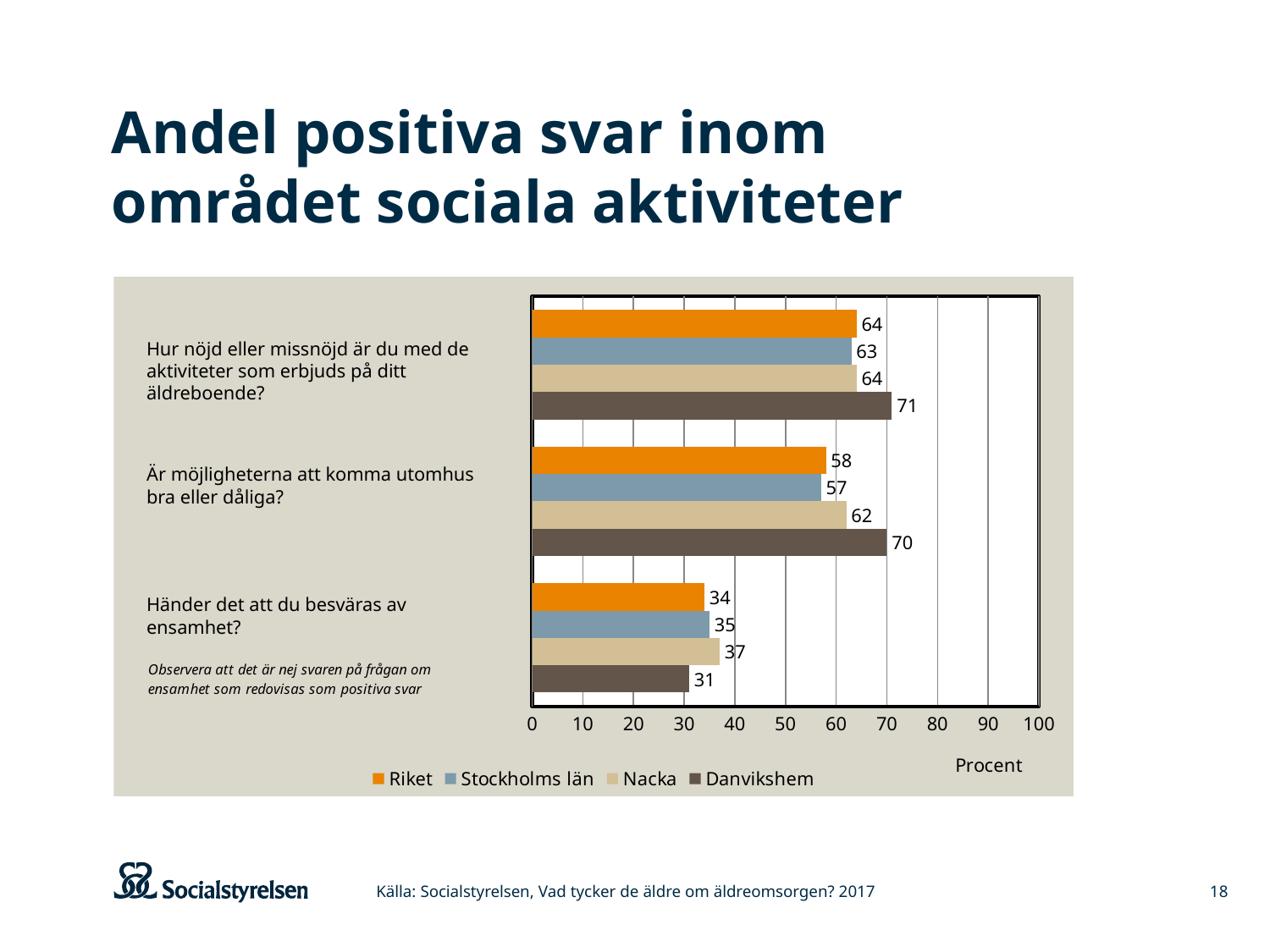
What is the value for Nacka on the question "Händer det att du besväras av ensamhet?"? 37 What kind of chart is shown on the slide? Bar chart Which colour represents Riket in the legend? Orange How many question categories are shown on the chart? 3 What is the value for Stockholms län on the question "Är möjligheterna att komma utomhus bra eller dåliga?"? 57 What is the value for Danvikshem on the question "Hur nöjd eller missnöjd är du med de aktiviteter som erbjuds på ditt äldreboende?"? 71 What is the difference between Danvikshem and Riket on the question "Är möjligheterna att komma utomhus bra eller dåliga?"? 12 How many series does the legend list? 4 Which series has the lowest value on the question "Händer det att du besväras av ensamhet?"? Danvikshem Which series has the highest value on the question "Är möjligheterna att komma utomhus bra eller dåliga?"? Danvikshem Which is larger on the question "Händer det att du besväras av ensamhet?": Nacka or Danvikshem? Nacka What is the maximum value shown on the horizontal axis? 100